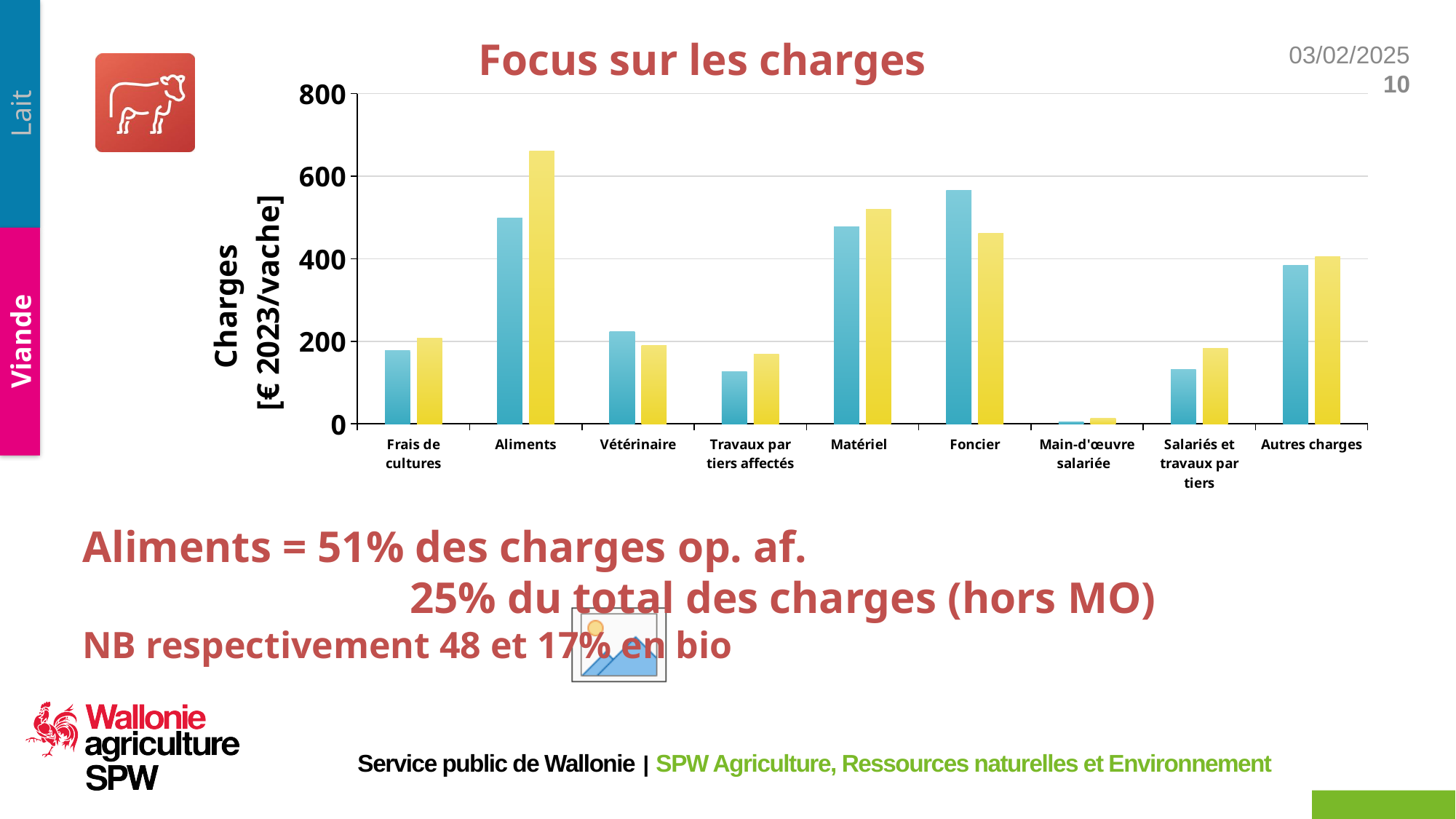
For Foncier, which bar is larger, the blue one or the yellow one? the blue one Which category has the lowest bars in the chart? Main-d'œuvre salariée What is the label of the vertical axis of the chart? Charges [€ 2023/vache] For Aliments, which bar is larger, the blue one or the yellow one? the yellow one Is the yellow bar for Aliments greater or less than 600? greater What kind of chart is shown on the slide? bar chart How many categories are shown on the x axis of the chart? 9 Is the blue bar for Travaux par tiers affectés greater or less than 200? less What is the title of the chart? Focus sur les charges Among the blue bars, which category is the highest? Foncier Is the blue bar for Foncier greater or less than 400? greater Which category has the tallest bar in the chart? Aliments